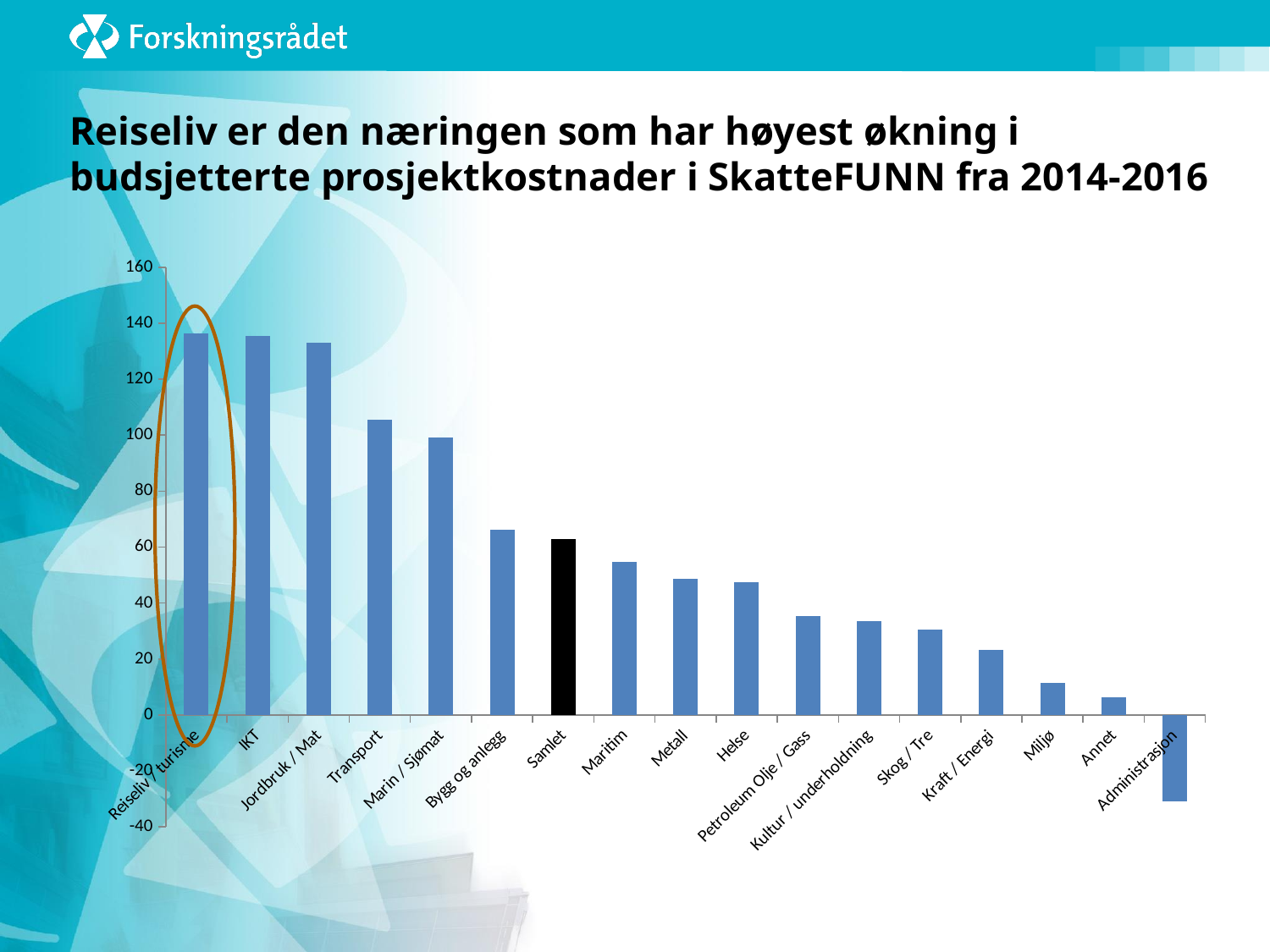
What kind of chart is shown on the slide? bar chart Which is larger, the value for Transport or the value for Bygg og anlegg? Transport Which category's bar is coloured black instead of blue? Samlet Is the value for Maritim greater or less than 60? less Which is larger, the value for Miljø or the value for Kraft / Energi? Kraft / Energi Is the value for Administrasjon greater or less than 0? less Which category has the lowest value? Administrasjon Do the values rise or fall moving from left to right along the x axis? fall Is the value for Petroleum Olje / Gass greater or less than 40? less How many categories are plotted along the x axis? 17